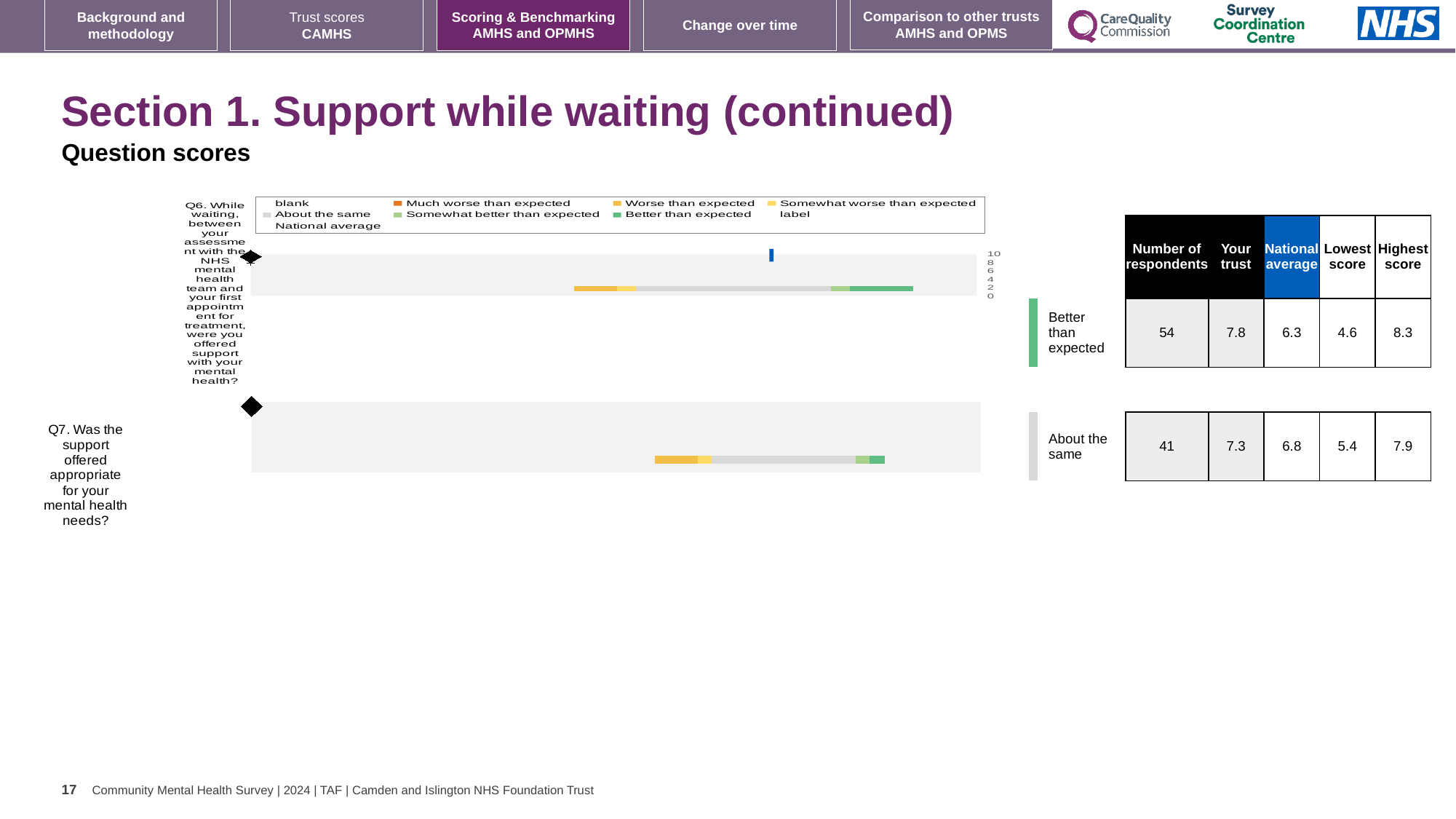
What kind of chart is used to show the question scores on this slide? bar chart What is the lowest score shown for Q6? 4.6 How many questions (categories) are plotted in the chart? 2 Which question has the higher 'Your trust' score, Q6 or Q7? Q6 What is the difference between the trust's score and the national average for Q6? 1.5 What is the highest score shown for Q7? 7.9 What is the difference between the highest and lowest scores for Q7? 2.5 How many respondents answered Q6? 54 What is the national average score for Q7 (was the support offered appropriate for your mental health needs)? 6.8 What benchmark category is the trust's Q6 score placed in? Better than expected Which question has the lower number of respondents? Q7 What is the 'Your trust' score for Q6 (support with your mental health while waiting)? 7.8